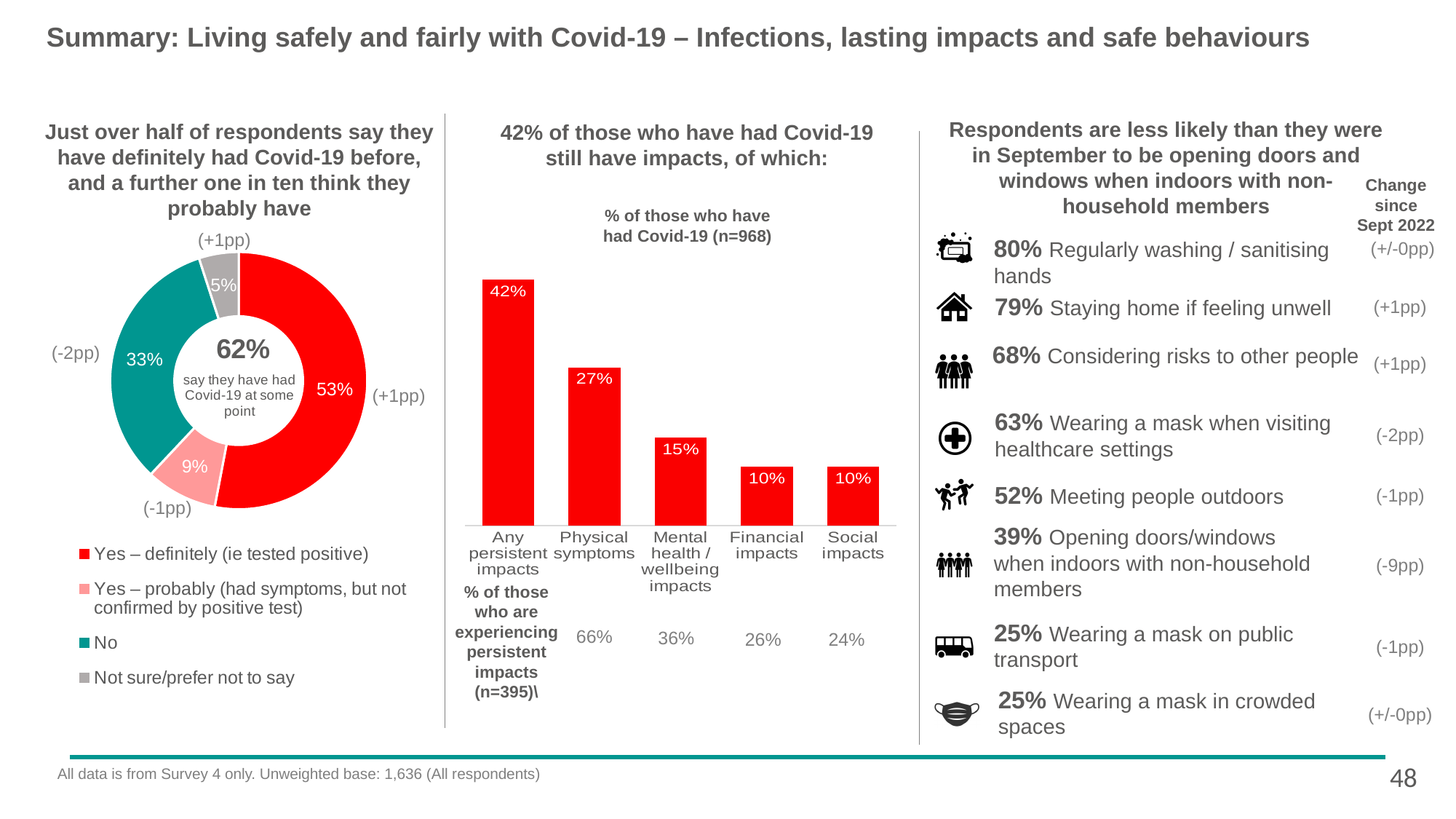
In the donut chart on the left, what is the difference between the 'Yes – definitely' share and the 'No' share? 20 percentage points In the bar chart in the middle, how many bars are plotted? 5 In the bar chart in the middle, what percentage of those who have had Covid-19 report physical symptoms? 27% In the bar chart in the middle, which category has the highest value? Any persistent impacts In the donut chart on the left, what figure is shown in the centre of the ring? 62% In the donut chart on the left, what percentage of respondents answered 'No'? 33% In the donut chart on the left, what percentage of respondents say they have definitely had Covid-19 (ie tested positive)? 53% What type of chart is shown in the middle of the slide? Bar chart In the bar chart in the middle, which is larger: 'Physical symptoms' or 'Financial impacts'? Physical symptoms In the bar chart in the middle, what is the difference between 'Any persistent impacts' and 'Mental health / wellbeing impacts'? 27 percentage points In the donut chart on the left, which category has the smallest share? Not sure/prefer not to say In the donut chart on the left, how many categories does the legend list? 4